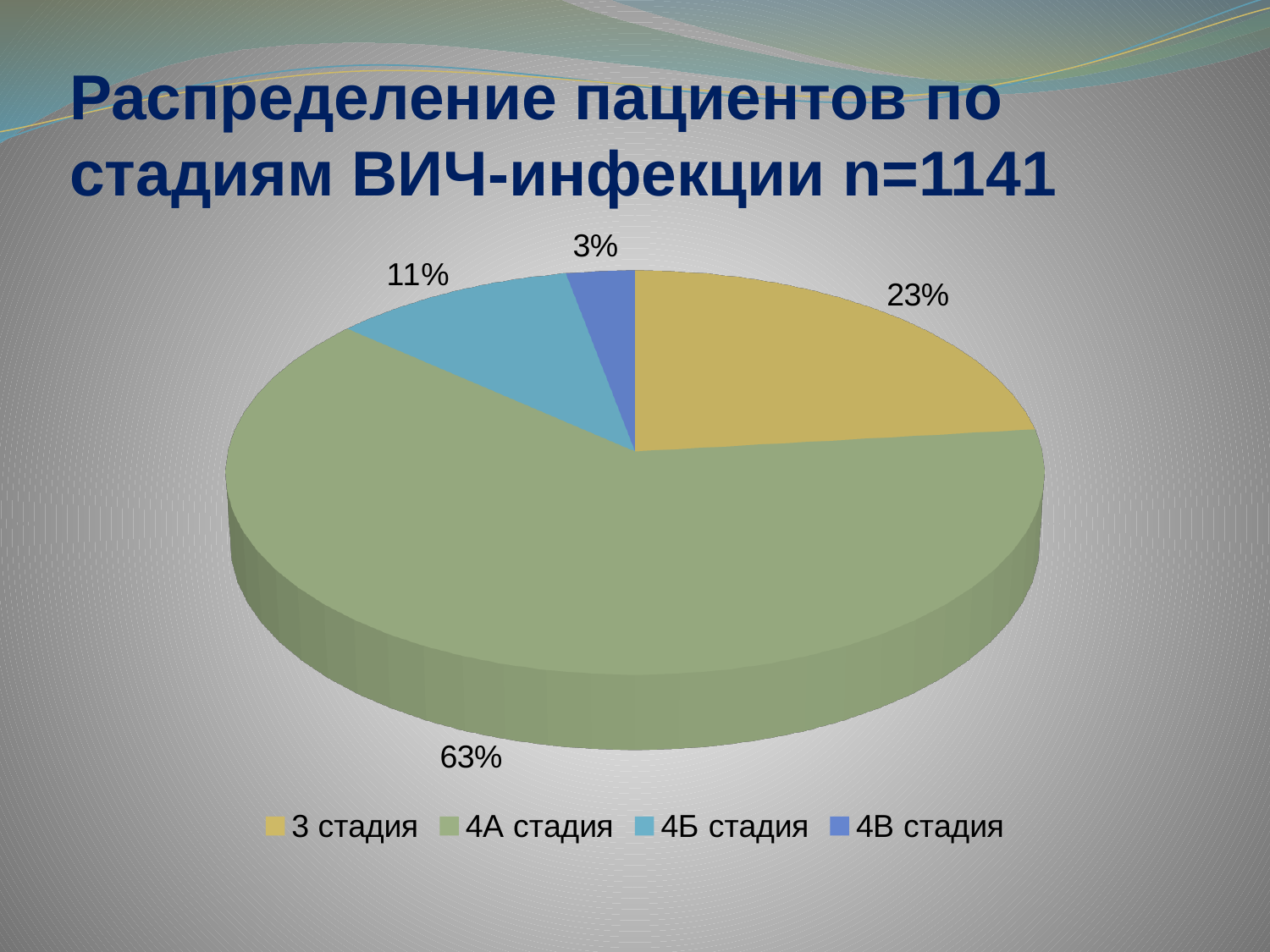
Which has a larger share, 3 стадия or 4Б стадия? 3 стадия What share of patients is in 4А стадия? 63% What kind of chart is shown on the slide? Pie chart Which stage has the largest share of patients? 4А стадия What is the title of the chart? Распределение пациентов по стадиям ВИЧ-инфекции n=1141 What share of patients is in 4Б стадия? 11% What share of patients is in 4В стадия? 3% What is the difference in percentage points between 4А стадия and 3 стадия? 40 Which stage has the smallest share of patients? 4В стадия What colour represents 4Б стадия in the legend? Light blue How many categories does the pie chart show? 4